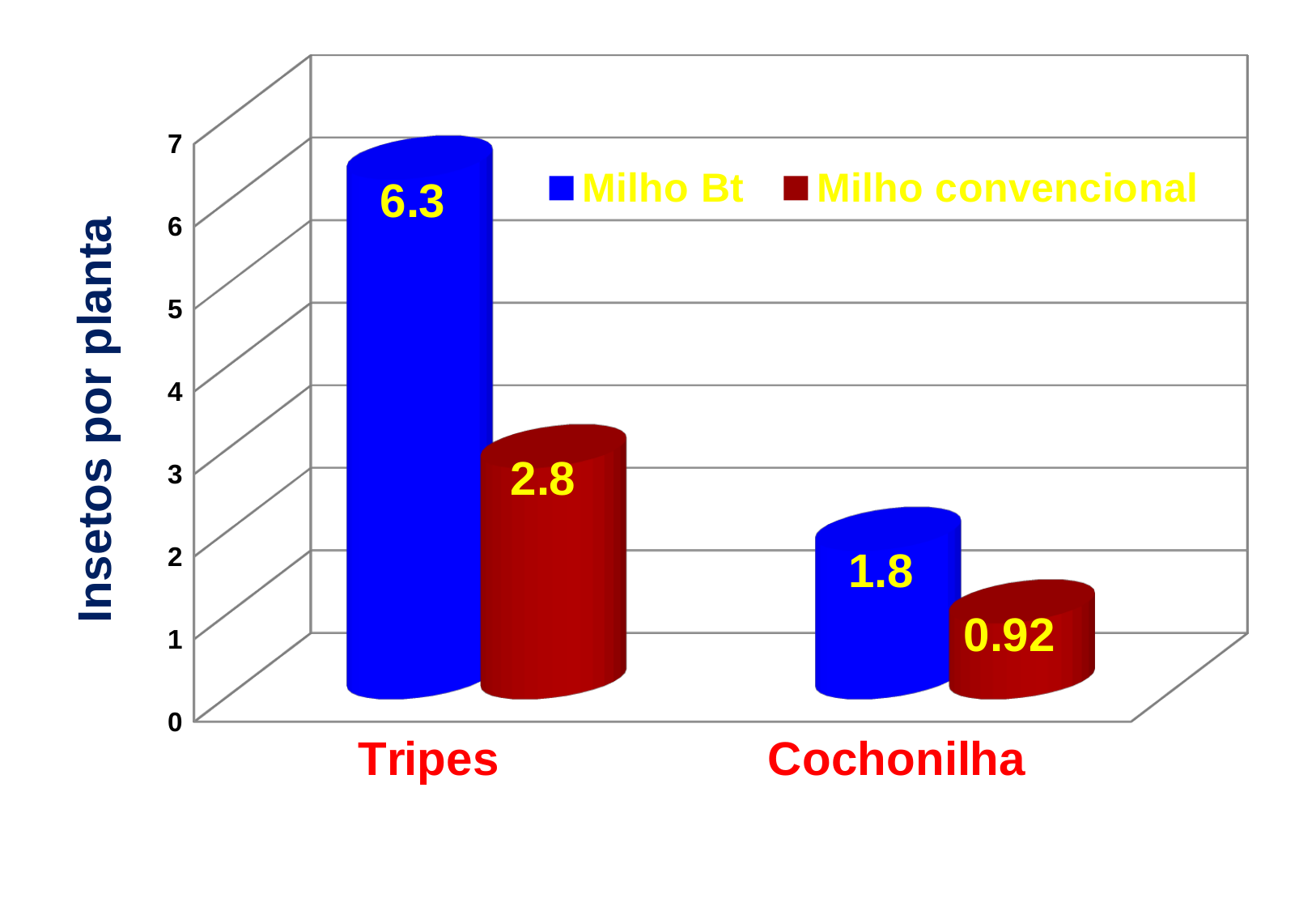
What is the value for Milho convencional in the Tripes category? 2.8 Which category has the highest value for Milho Bt? Tripes How many categories are shown on the x axis? 2 What kind of chart is shown on the slide? Bar chart What is the value for Milho convencional in the Cochonilha category? 0.92 Which category has the lowest value for Milho convencional? Cochonilha Which is larger in the Cochonilha category, Milho Bt or Milho convencional? Milho Bt What is the label of the vertical axis? Insetos por planta What is the difference between Milho Bt and Milho convencional in the Tripes category? 3.5 What is the value for Milho Bt in the Tripes category? 6.3 What is the value for Milho Bt in the Cochonilha category? 1.8 How many series does the legend list? 2